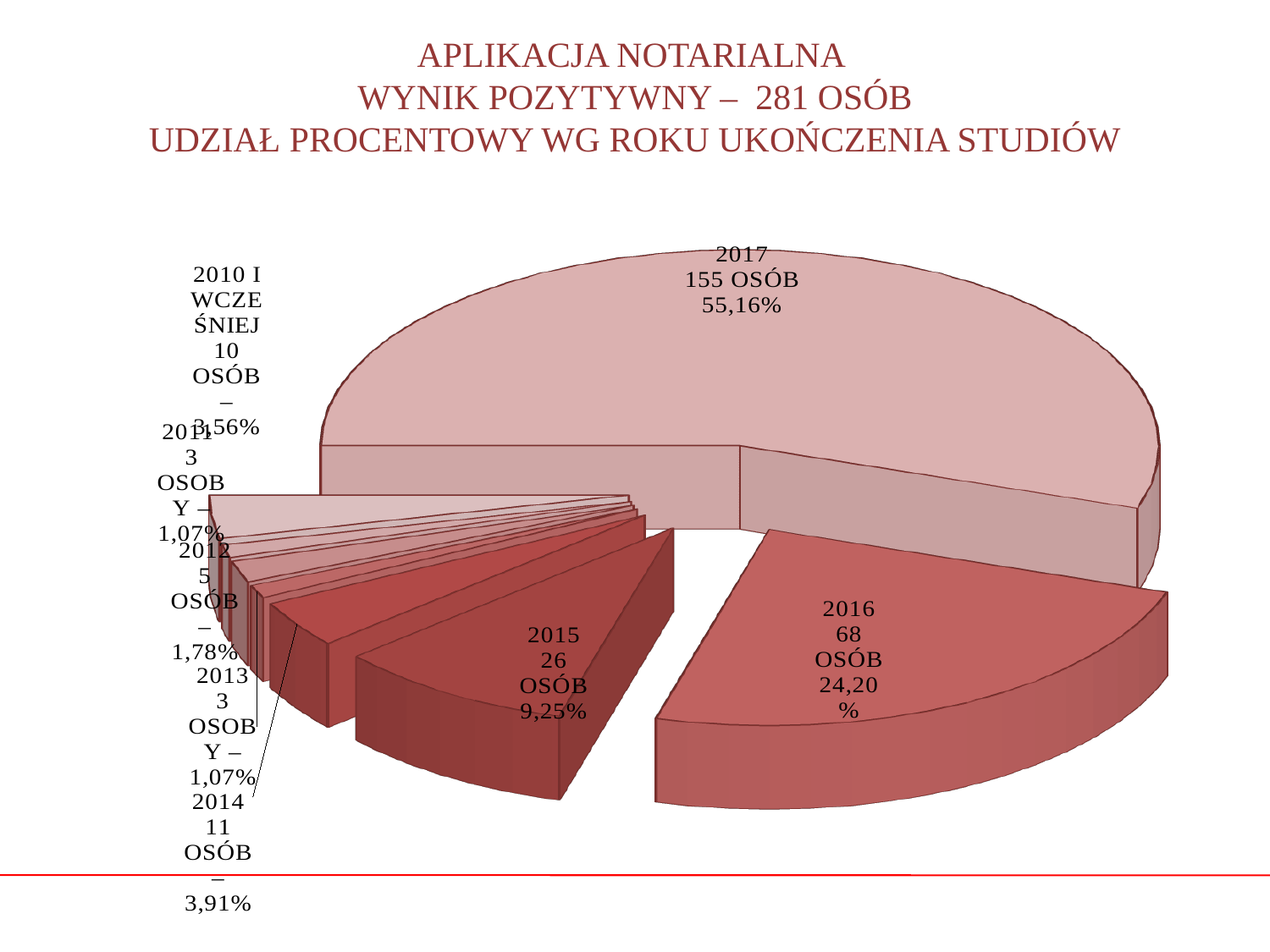
What percentage is shown for 2015? 9,25% How many slices does the pie chart have? 8 Which is larger, the share for 2016 or the share for 2015? 2016 What percentage share does the 2017 slice have? 55,16% What percentage is shown for the category '2010 I WCZEŚNIEJ'? 3,56% What percentage is shown for 2012? 1,78% How many people are shown for 2014? 11 OSÓB Which year has the largest share of the pie? 2017 What is the difference in number of people between 2017 and 2016? 87 How many people (osób) are in the 2016 slice? 68 OSÓB According to the chart title, how many people in total achieved a positive result? 281 OSÓB What kind of chart is shown on the slide? pie chart